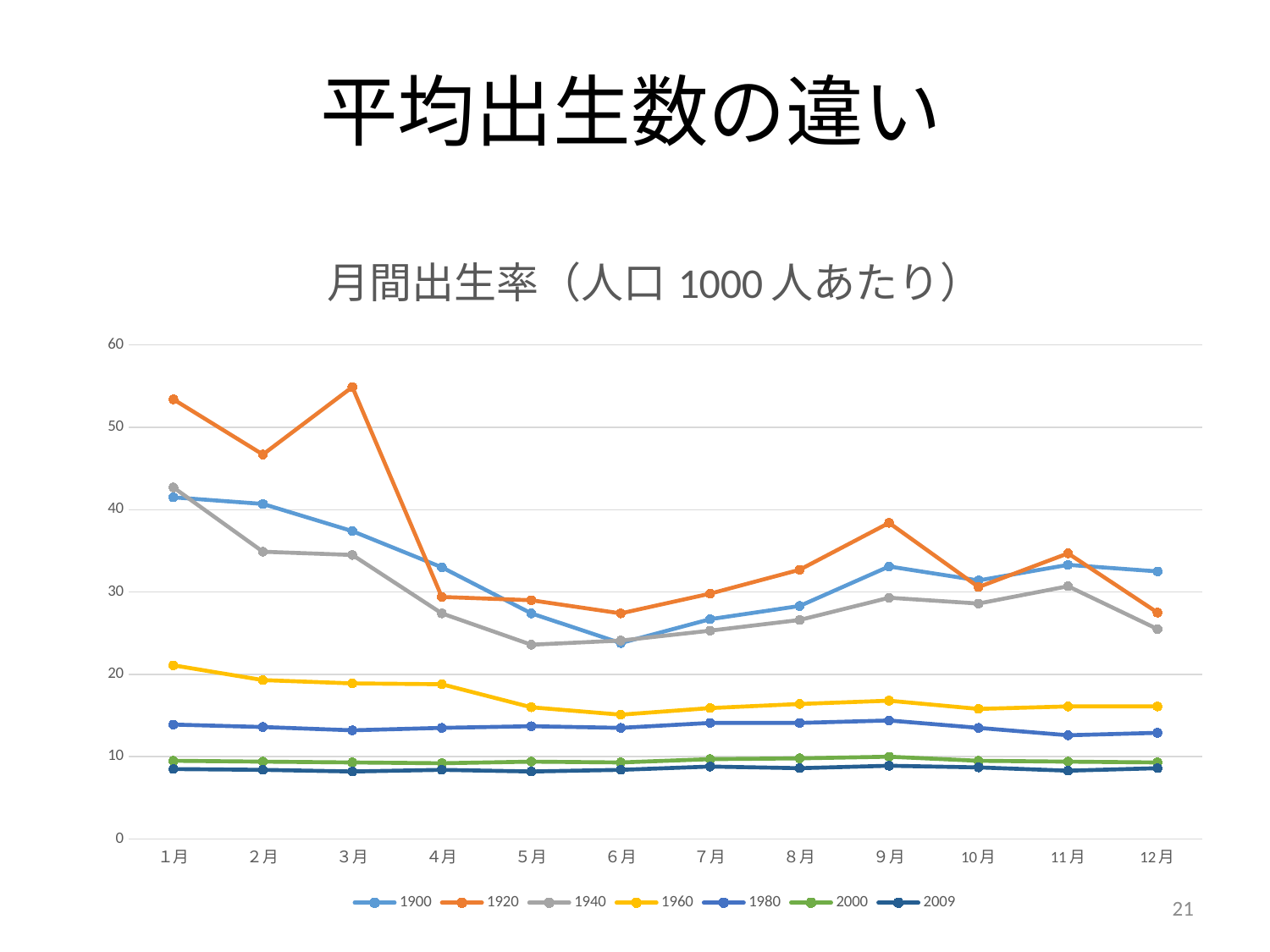
Which series has the lowest value in 1月? 2009 How many months are plotted along the x axis? 12 Is the value for 1920 in 3月 greater or less than 50? greater In which month does the 1920 series reach its highest value? 3月 Is the value for 1980 in 9月 greater or less than 10? greater Does the 1960 series rise or fall from 1月 to 6月? fall What kind of chart is shown on the slide? line chart What is the title of the chart? 月間出生率（人口 1000 人あたり） Is the value for 1960 in 6月 greater or less than 20? less In 6月, which is larger, the value for 1920 or the value for 1900? 1920 Which series has the highest value in 1月? 1920 How many series does the legend list? 7